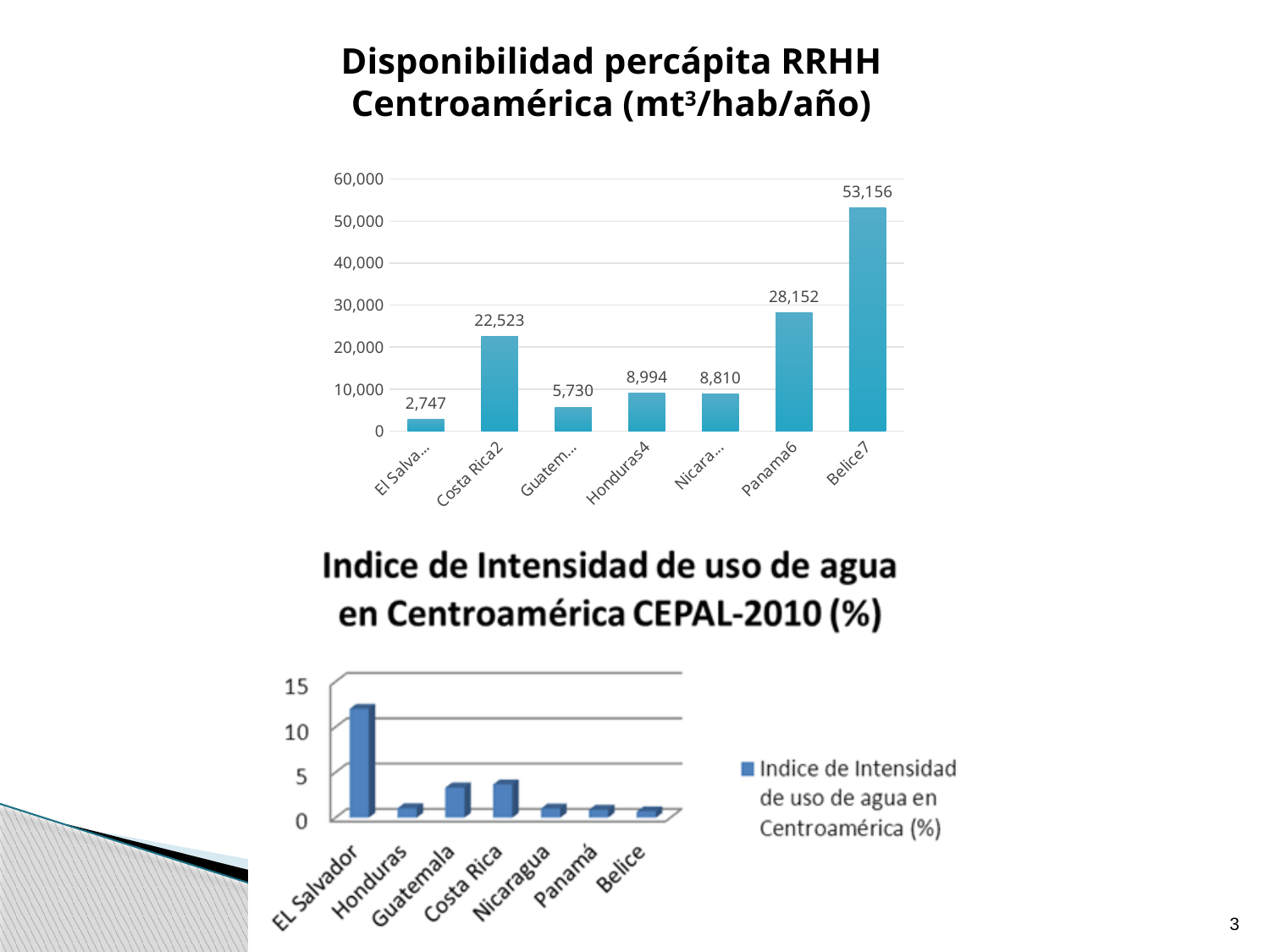
In the bottom chart (Indice de Intensidad de uso de agua en Centroamérica), is the value for El Salvador greater or less than 10? greater In the top chart (Disponibilidad percápita RRHH Centroamérica), which is larger, the value for Costa Rica2 or the value for Panama6? Panama6 In the top chart (Disponibilidad percápita RRHH Centroamérica), what is the value for Belice7? 53,156 In the bottom chart (Indice de Intensidad de uso de agua en Centroamérica), is the value for Honduras greater or less than 5? less In the top chart (Disponibilidad percápita RRHH Centroamérica), which category has the highest value? Belice7 In the top chart (Disponibilidad percápita RRHH Centroamérica), how many bars are plotted? 7 In the top chart (Disponibilidad percápita RRHH Centroamérica), what is the value for Panama6? 28,152 What kind of chart is the top chart (Disponibilidad percápita RRHH Centroamérica)? Bar chart In the bottom chart (Indice de Intensidad de uso de agua en Centroamérica), which country has the highest value? El Salvador In the top chart (Disponibilidad percápita RRHH Centroamérica), what is the value for Costa Rica2? 22,523 In the top chart (Disponibilidad percápita RRHH Centroamérica), what is the value for Honduras4? 8,994 In the top chart (Disponibilidad percápita RRHH Centroamérica), what is the difference between the values for Belice7 and Panama6? 25,004